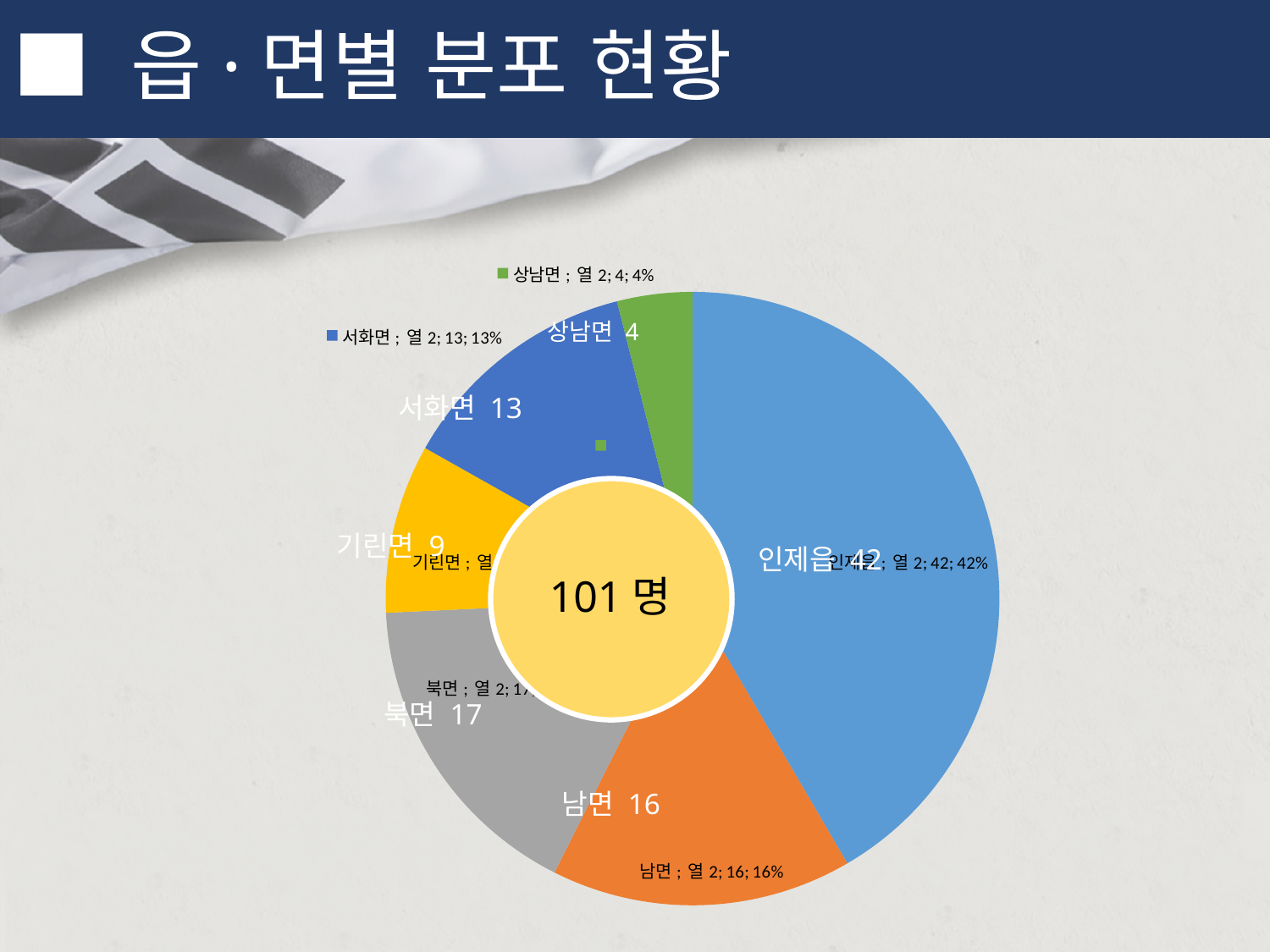
What is the difference between the values for 인제읍 and 남면? 26 What is the value for 서화면? 13 What total is printed in the centre of the pie chart? 101 명 What type of chart is shown on the slide? pie chart What is the value for 북면? 17 How many categories does the pie chart have? 6 Which category has the smallest slice of the pie? 상남면 Which category has the largest slice of the pie? 인제읍 What share of the pie does 남면 represent, as printed on the slide? 16% What is the value for 상남면? 4 Which is larger, the value for 북면 or the value for 기린면? 북면 What is the value for 인제읍? 42